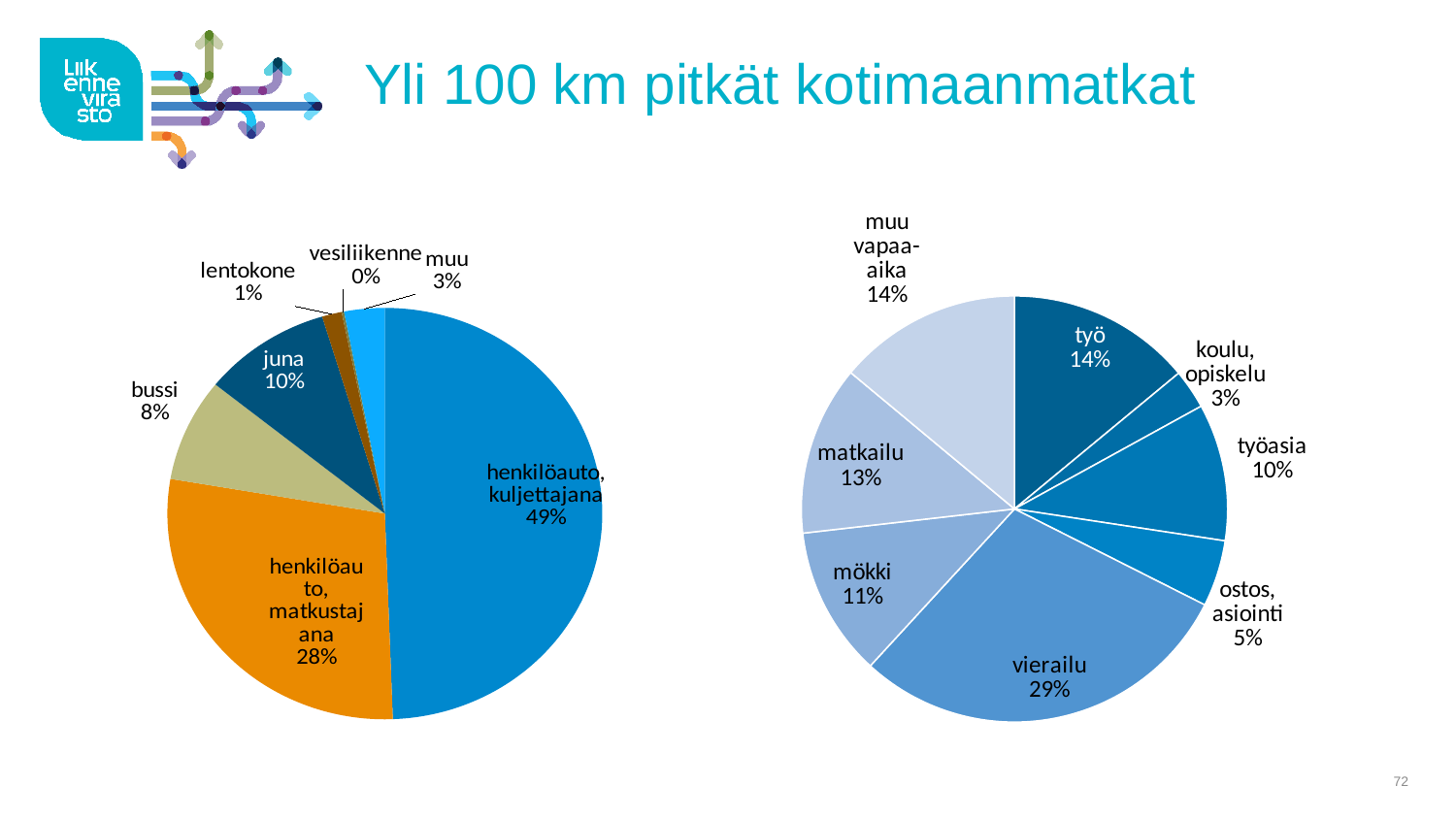
In the left pie chart, which category has the smallest share? vesiliikenne In the left pie chart, how many categories are shown? 7 In the right pie chart, what share is labelled for 'vierailu'? 29% In the right pie chart, which is larger, 'matkailu' or 'mökki'? matkailu What type of chart is used on the slide? Pie chart In the left pie chart, what share is labelled for 'henkilöauto, kuljettajana'? 49% In the left pie chart, which category has the largest share? henkilöauto, kuljettajana In the right pie chart, how many categories are shown? 8 In the right pie chart, which category has the largest share? vierailu In the right pie chart, what share is labelled for 'ostos, asiointi'? 5% In the left pie chart, what share is labelled for 'juna'? 10% In the left pie chart, what is the difference in percentage points between 'henkilöauto, kuljettajana' and 'henkilöauto, matkustajana'? 21 percentage points